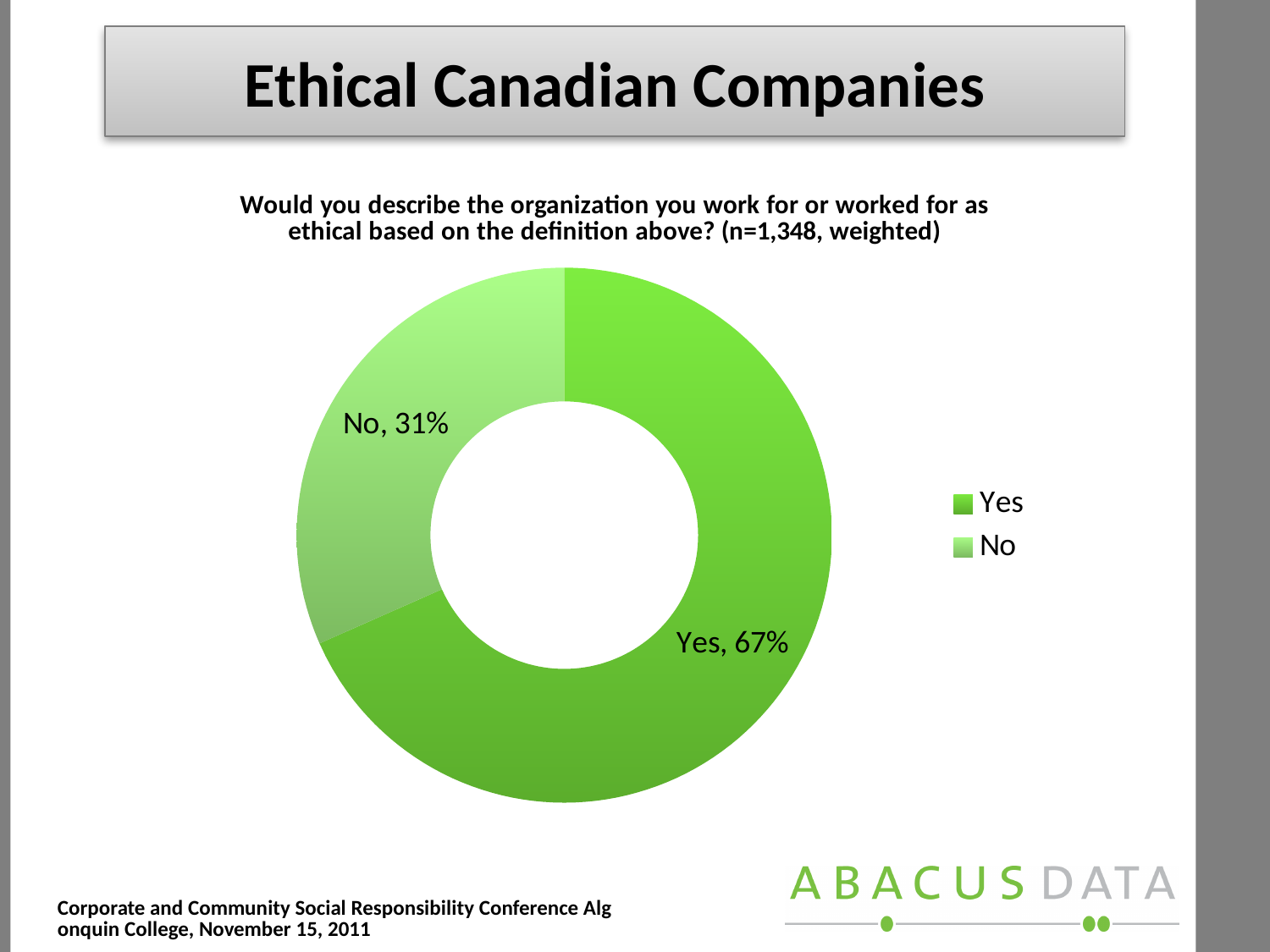
What is the difference in percentage points between the Yes and No responses? 36 What is the sample size stated in the chart's question text? n=1,348 What percentage of respondents answered Yes? 67% What kind of chart is shown on the slide? Doughnut (pie) chart What is the title of the slide? Ethical Canadian Companies How many categories are shown in the chart? 2 Which is larger, the share for Yes or the share for No? Yes Which response has the largest share of the chart? Yes Which response has the smallest share of the chart? No How many entries does the legend list? 2 What percentage of respondents answered No? 31%